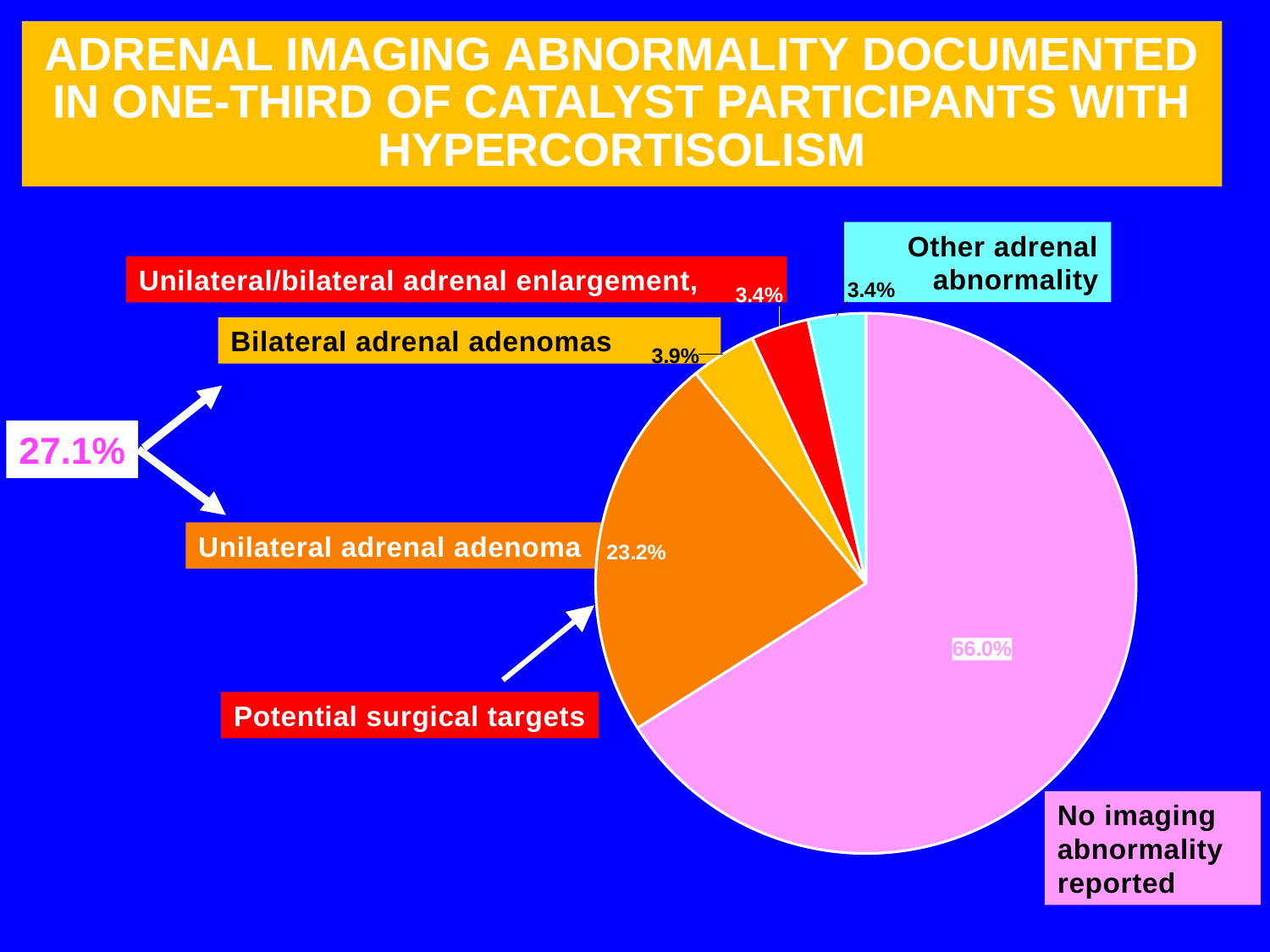
How many slices does the pie chart have? 5 Which is larger, the 'Bilateral adrenal adenomas' slice or the 'Unilateral adrenal adenoma' slice? Unilateral adrenal adenoma What colour is the 'No imaging abnormality reported' slice? pink What kind of chart is shown on the slide? pie chart Which slice of the pie chart is the largest? No imaging abnormality reported What percentage of the pie is labelled 'Unilateral adrenal adenoma'? 23.2% What is the difference between the 'No imaging abnormality reported' slice and the 'Unilateral adrenal adenoma' slice? 42.8% What is the combined percentage of the 'Bilateral adrenal adenomas' and 'Unilateral adrenal adenoma' slices, as shown on the slide? 27.1% What percentage of the pie is labelled 'Bilateral adrenal adenomas'? 3.9% What label is shown in the red box with an arrow pointing to the orange slice? Potential surgical targets What percentage of the pie is labelled 'Other adrenal abnormality'? 3.4% What percentage of the pie is labelled 'No imaging abnormality reported'? 66.0%